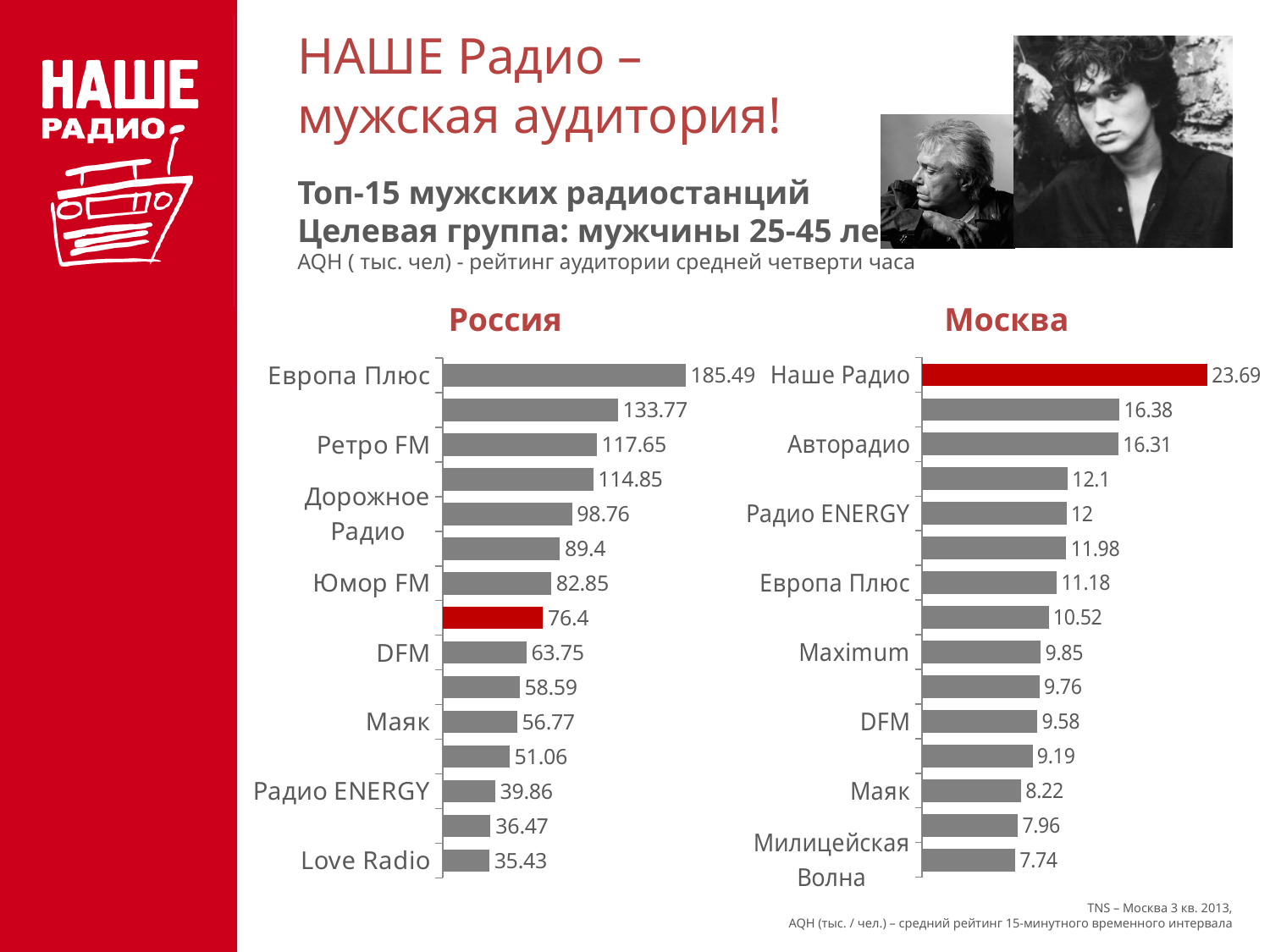
In the Россия chart, which labelled station has the lowest value? Love Radio In the Москва chart, which station has the highest value? Наше Радио In the Россия chart, what is the value for Love Radio? 35.43 In the Москва chart, what is the value for Милицейская Волна? 7.74 In the Москва chart, what is the difference between Наше Радио and Авторадио? 7.38 In the Россия chart, which is larger: Юмор FM or DFM? Юмор FM In the Россия chart, what is the value of the red bar? 76.4 How many bars are in the Москва chart? 15 In the Москва chart, what is the value for Наше Радио? 23.69 In the Россия chart, what is the value for Ретро FM? 117.65 What type of chart is used for the Россия data? Bar chart In the Россия chart, what is the value for Европа Плюс? 185.49